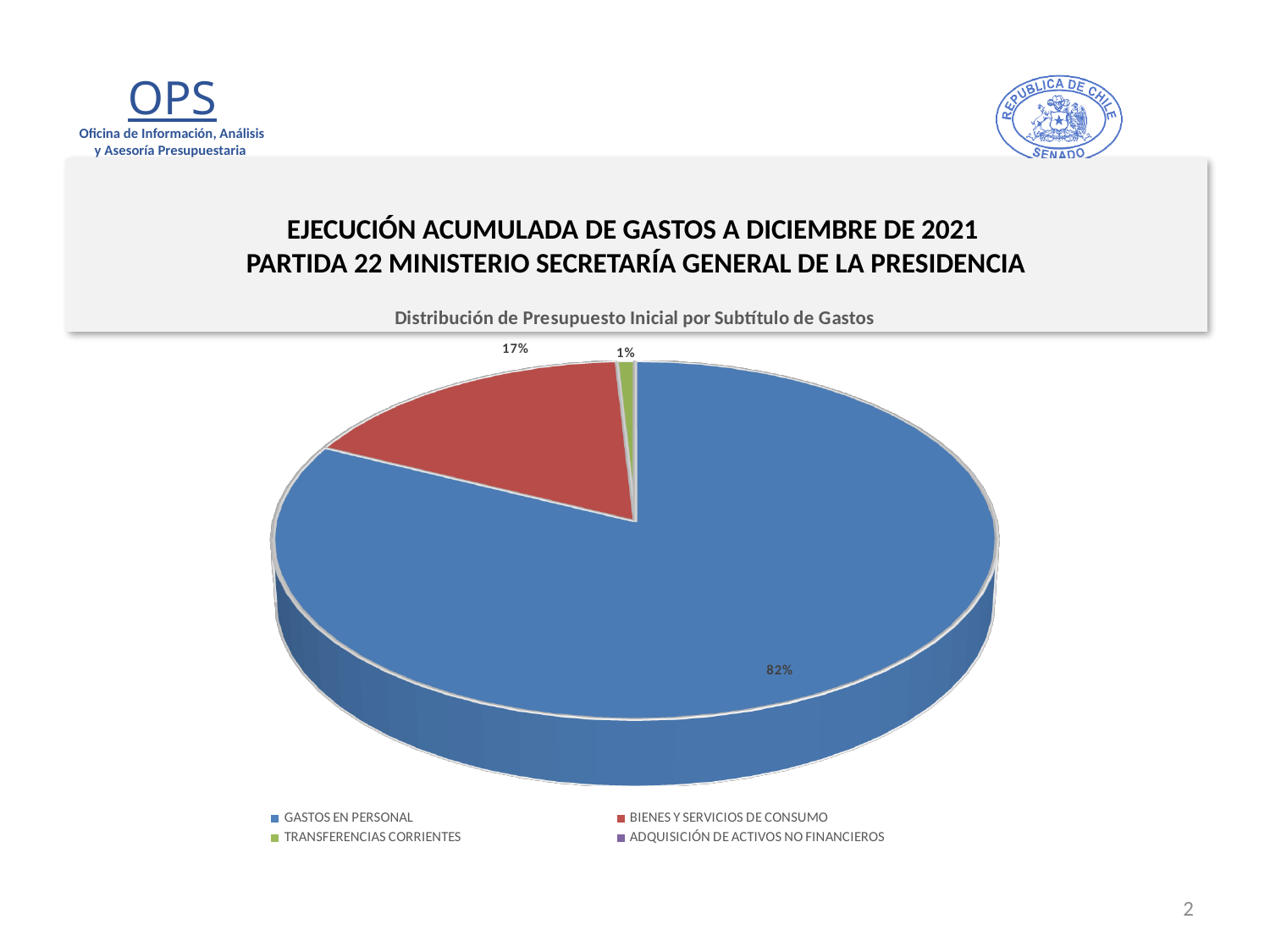
What colour is the slice for GASTOS EN PERSONAL? blue Which category has the largest share of the pie? GASTOS EN PERSONAL What share of the pie does GASTOS EN PERSONAL represent? 82% What is the chart's title? Distribución de Presupuesto Inicial por Subtítulo de Gastos What is the difference in percentage points between the GASTOS EN PERSONAL share and the BIENES Y SERVICIOS DE CONSUMO share? 65 What share of the pie does BIENES Y SERVICIOS DE CONSUMO represent? 17% Which of the labelled slices has the smallest share of the pie? TRANSFERENCIAS CORRIENTES How many categories does the legend list? 4 What share of the pie does TRANSFERENCIAS CORRIENTES represent? 1% Which is larger, the share for BIENES Y SERVICIOS DE CONSUMO or the share for TRANSFERENCIAS CORRIENTES? BIENES Y SERVICIOS DE CONSUMO Is the share for GASTOS EN PERSONAL greater or less than 50%? greater What kind of chart is shown on the slide? pie chart